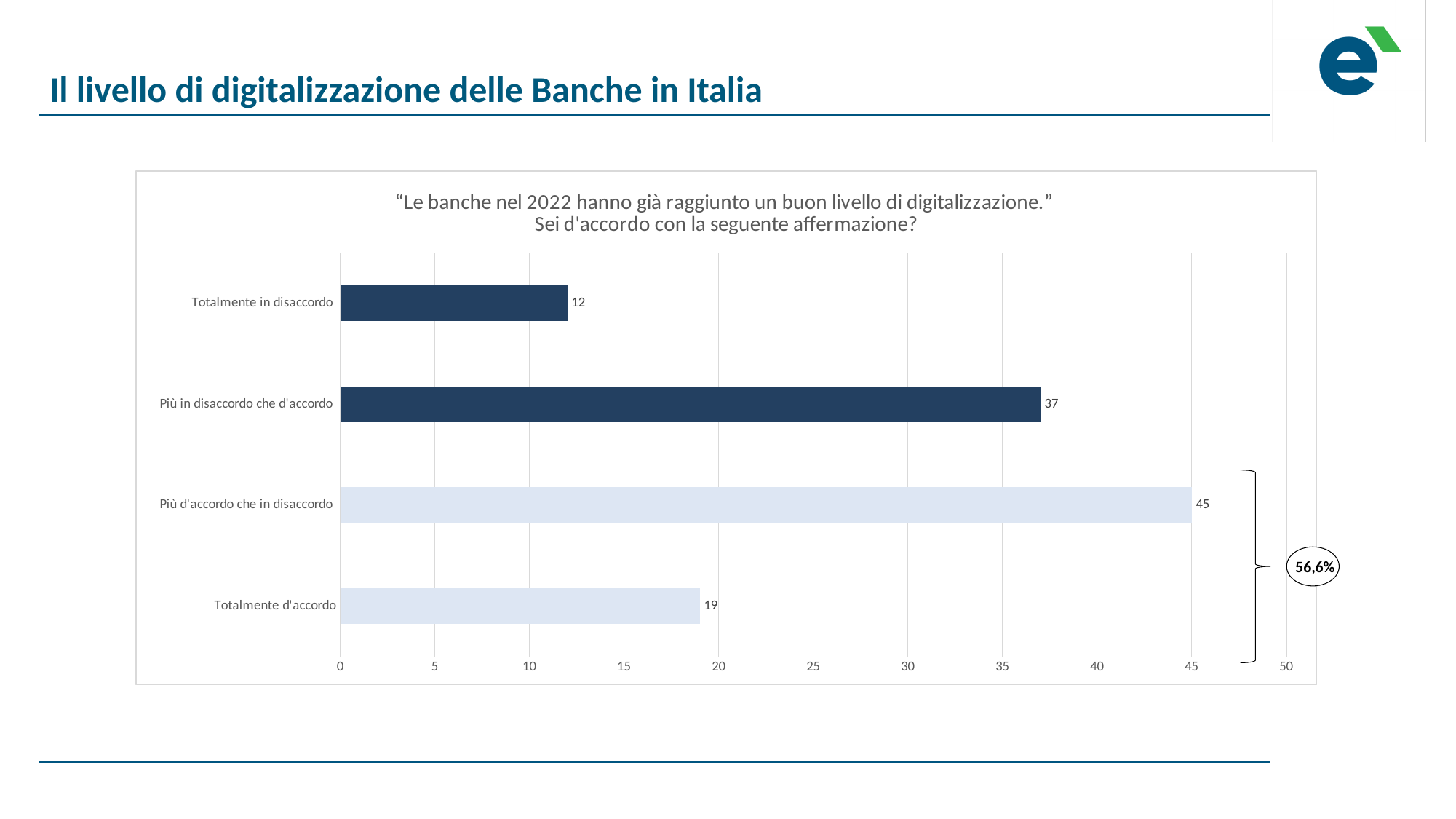
Which is larger, the value for "Totalmente d'accordo" or the value for "Totalmente in disaccordo"? Totalmente d'accordo How many categories are shown in the chart? 4 Is the value for "Più in disaccordo che d'accordo" greater or less than 35? greater What kind of chart is shown on the slide? Bar chart Which category has the lowest value? Totalmente in disaccordo Which category has the highest value? Più d'accordo che in disaccordo What is the difference between the values for "Più d'accordo che in disaccordo" and "Più in disaccordo che d'accordo"? 8 What percentage is shown in the circle next to the bracket grouping the two agreement categories? 56,6% What is the total of the values for "Più d'accordo che in disaccordo" and "Totalmente d'accordo"? 64 What is the value for "Totalmente d'accordo"? 19 What is the value for "Totalmente in disaccordo"? 12 What is the value for "Più in disaccordo che d'accordo"? 37